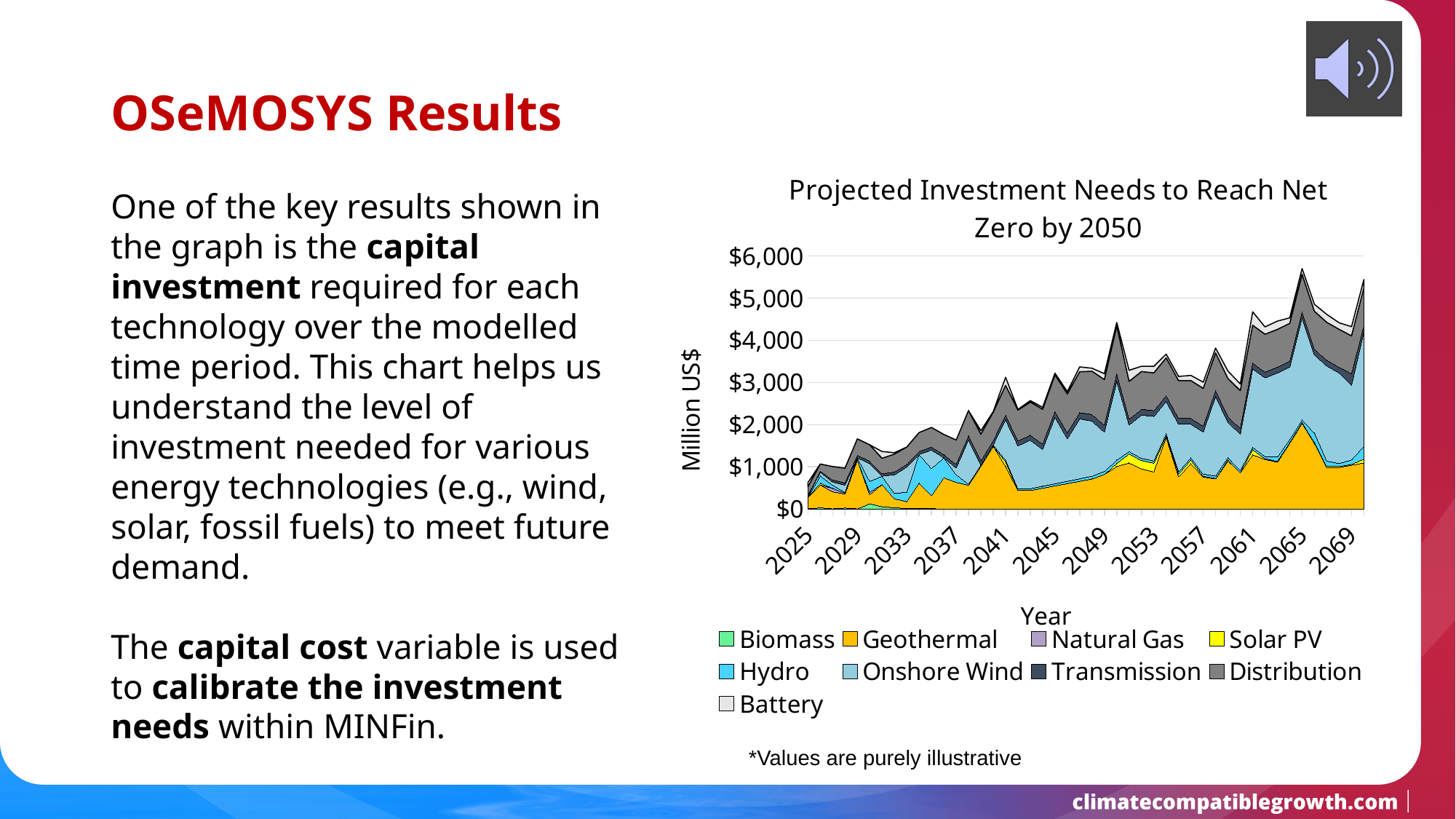
Is the total investment need in 2041 greater or less than $2,000 million? greater What is the label on the vertical axis of the chart? Million US$ Is the total investment need in 2025 greater or less than $1,000 million? less What is the title of the chart? Projected Investment Needs to Reach Net Zero by 2050 How many series does the legend of the chart list? 9 Is the total investment need in 2061 greater or less than $3,000 million? greater Which is larger, the total investment need in 2069 or in 2025? 2069 What kind of chart is shown on the slide? Stacked area chart Do the total projected investment needs generally rise or fall from 2025 to 2069? Rise How many year labels are shown on the x axis of the chart? 12